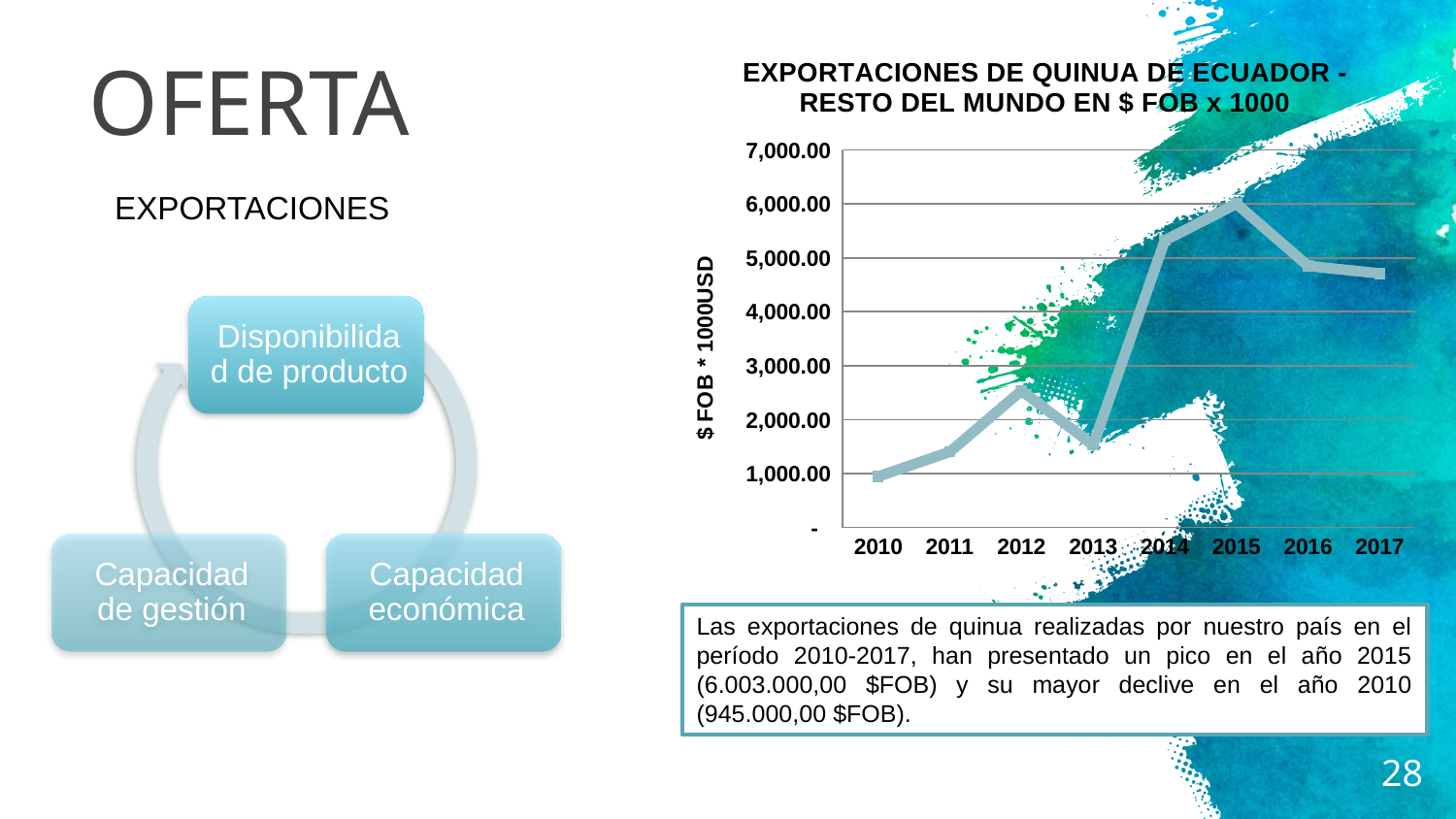
Which year has the larger export value, 2012 or 2013? 2012 Is the value for 2012 greater or less than 2,000.00? greater How many years are plotted on the x axis of the chart? 8 What kind of chart is shown on the slide? line chart Which year has the lowest export value in the chart? 2010 Is the value for 2013 greater or less than 2,000.00? less Which year has the highest export value in the chart? 2015 Is the value for 2010 greater or less than 1,000.00? less What is the label on the y axis of the chart? $ FOB * 1000USD Which year has the larger export value, 2014 or 2016? 2014 Do the values rise or fall from 2015 to 2017? fall